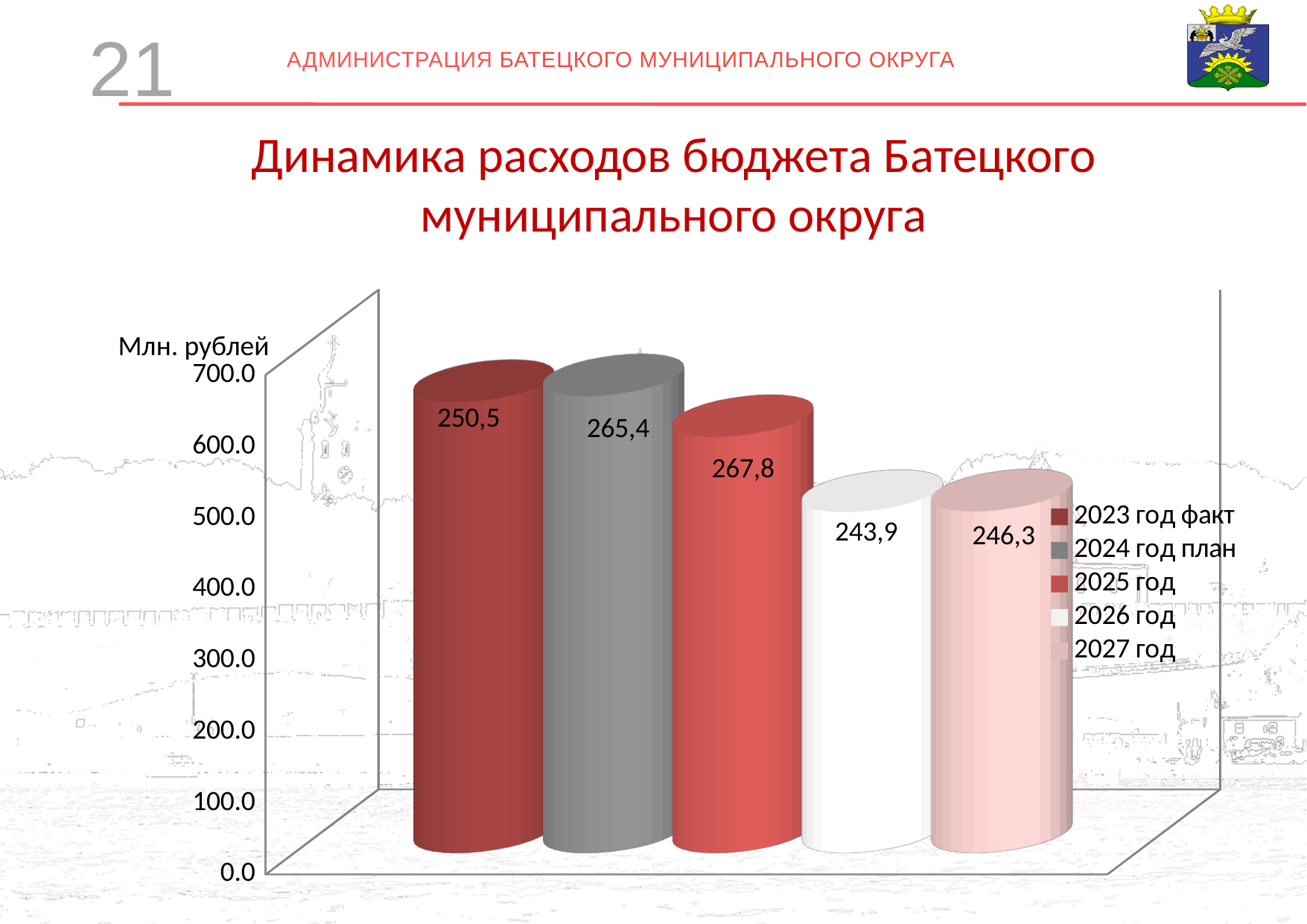
Which is larger, the value for 2023 год факт or the value for 2027 год? 2023 год факт What is the difference between the values for 2024 год план and 2023 год факт? 14,9 What is the value for 2023 год факт? 250,5 What is the value for 2024 год план? 265,4 What is the value for 2026 год? 243,9 What unit is shown on the vertical axis of the chart? Млн. рублей Which year has the lowest expenditure value? 2026 год What is the difference between the values for 2025 год and 2026 год? 23,9 What is the value for 2027 год? 246,3 How many bars are plotted on the chart? 5 How many entries does the legend list? 5